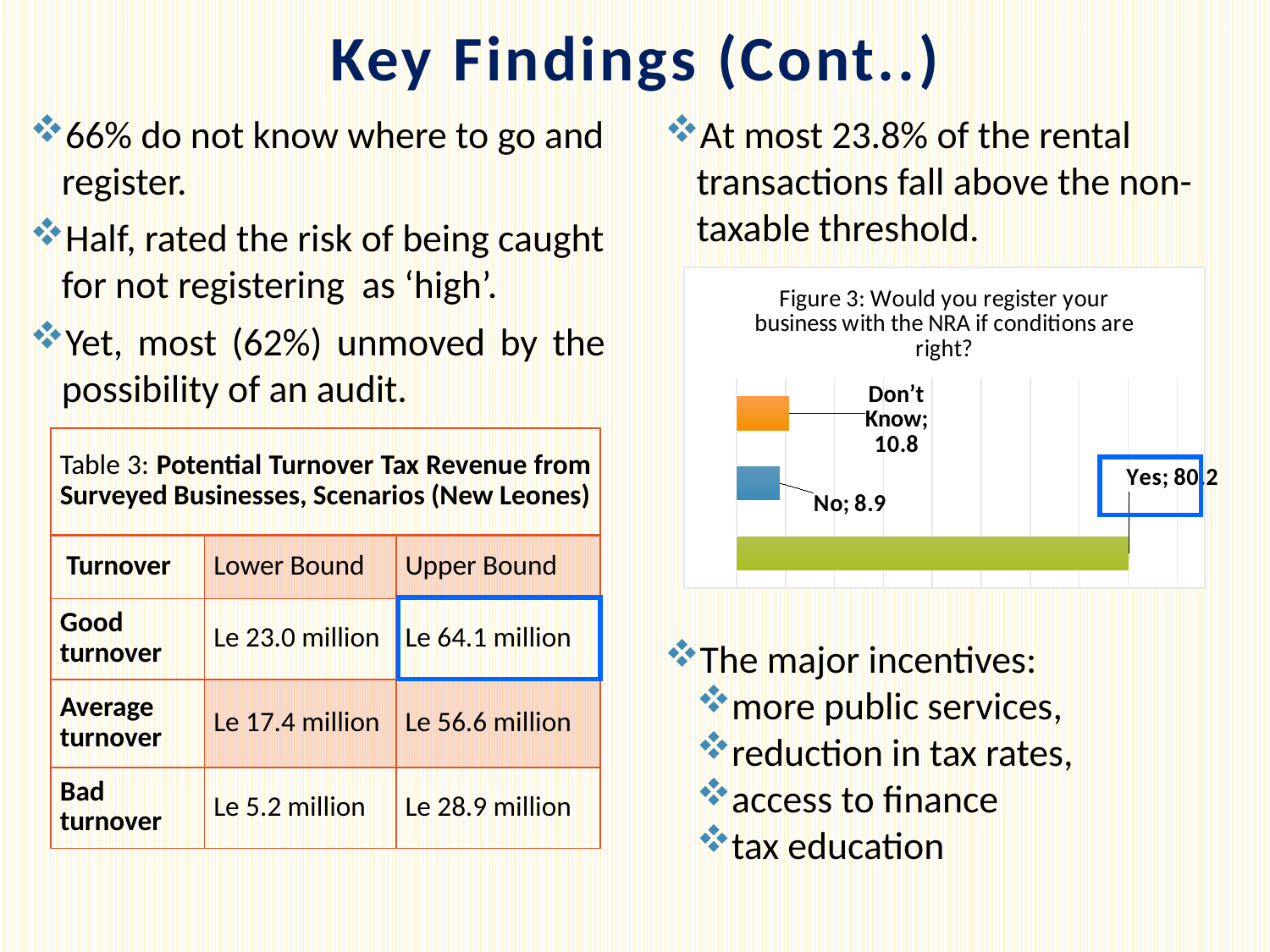
What kind of chart is Figure 3? Bar chart How many response categories are plotted in the Figure 3 chart? 3 Which response has the highest value in the Figure 3 chart? Yes In the Figure 3 chart, which is larger: the value for "Don't Know" or the value for "No"? Don't Know What is the title of the chart on the slide? Figure 3: Would you register your business with the NRA if conditions are right? In the Figure 3 chart, what is the difference between the values for "Yes" and "Don't Know"? 69.4 In the Figure 3 chart, what is the difference between the values for "Don't Know" and "No"? 1.9 What colour is the "Yes" bar in the Figure 3 chart? Green What value is shown for "Yes" in the Figure 3 chart? 80.2 What value is shown for "Don't Know" in the Figure 3 chart? 10.8 What value is shown for "No" in the Figure 3 chart? 8.9 Which response has the lowest value in the Figure 3 chart? No